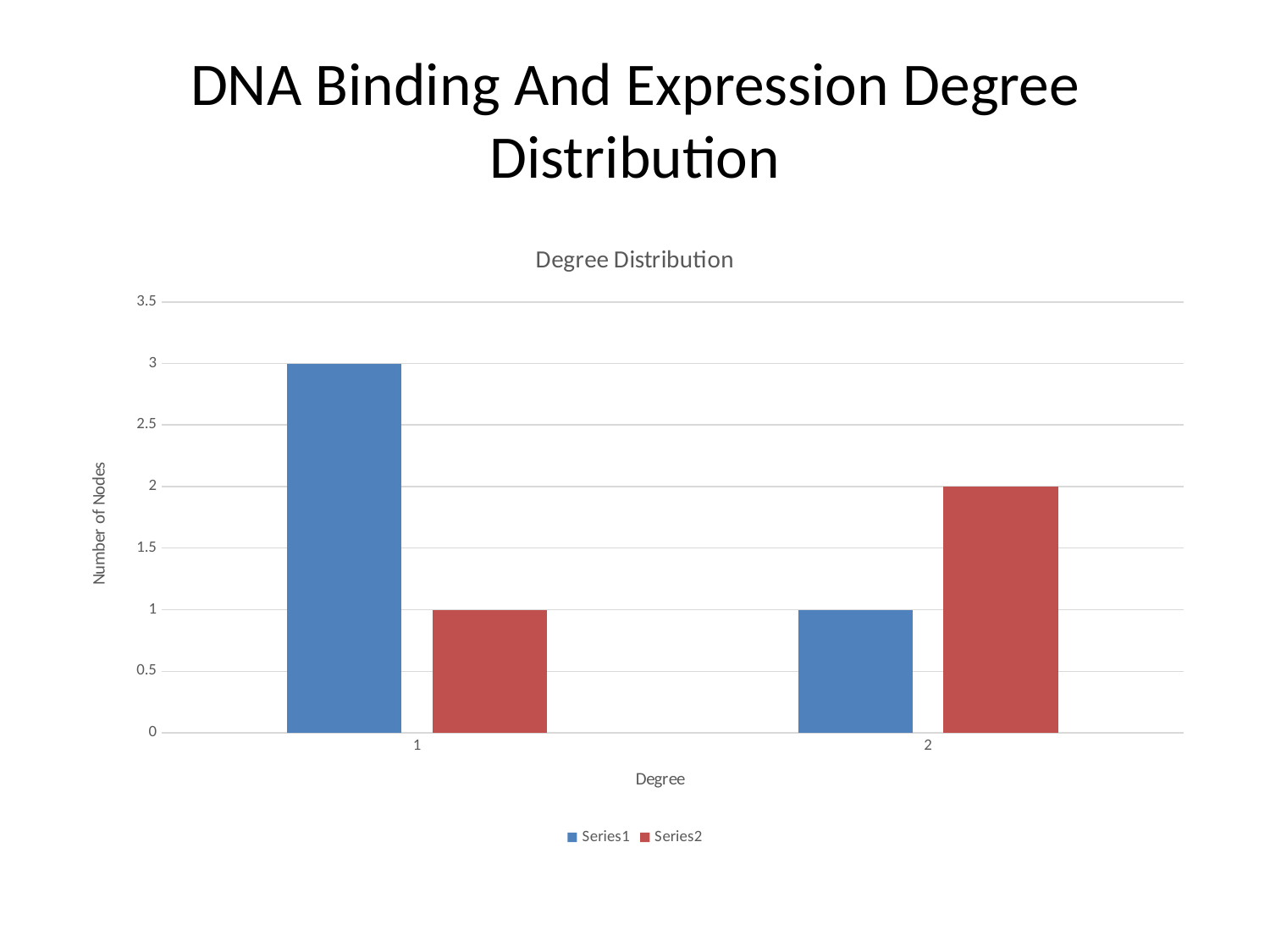
What is the value of Series2 at degree 2? 2 At degree 2, which series has the larger value, Series1 or Series2? Series2 What is the value of Series2 at degree 1? 1 Does Series1 rise or fall from degree 1 to degree 2? fall What type of chart is shown on the slide? bar chart At which degree is Series1 highest? 1 What is the value of Series1 at degree 2? 1 What is the difference between Series1 and Series2 at degree 1? 2 What is the chart's title? Degree Distribution What is the value of Series1 at degree 1? 3 How many series does the legend list? 2 How many degree categories are shown on the x axis? 2